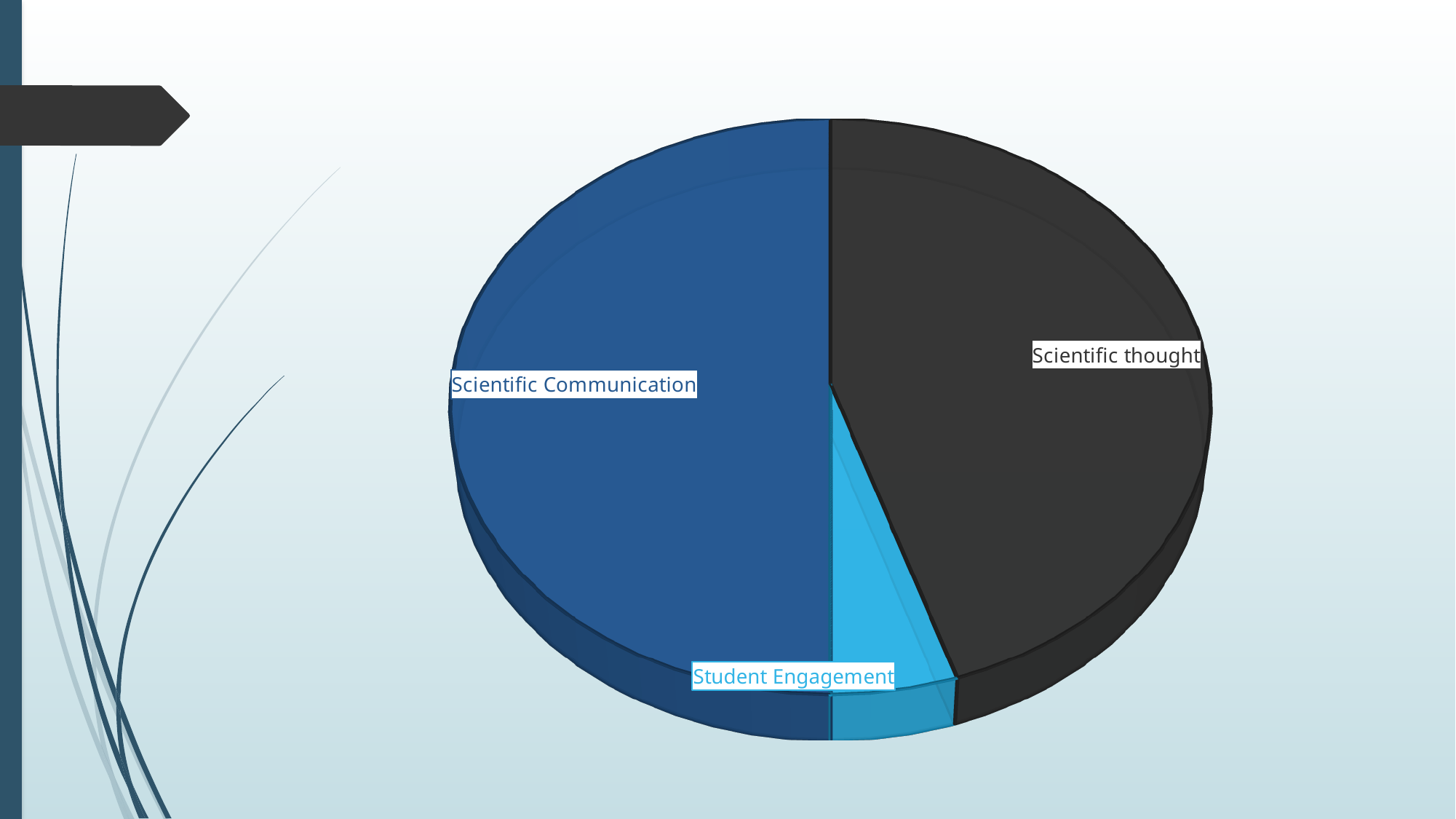
Does the Scientific Communication slice take up more or less than a quarter of the pie? more How many slices does the pie chart have? 3 Which slice is larger, Scientific Communication or Scientific thought? Scientific Communication What kind of chart is shown on the slide? Pie chart What colour is the Scientific thought slice? Dark grey What colour is the Student Engagement slice? Light blue Which slice of the pie chart is the smallest? Student Engagement Which slice is larger, Scientific Communication or Student Engagement? Scientific Communication Which slice is larger, Scientific thought or Student Engagement? Scientific thought Which slice of the pie chart is the largest? Scientific Communication Does the Student Engagement slice take up more or less than a quarter of the pie? less